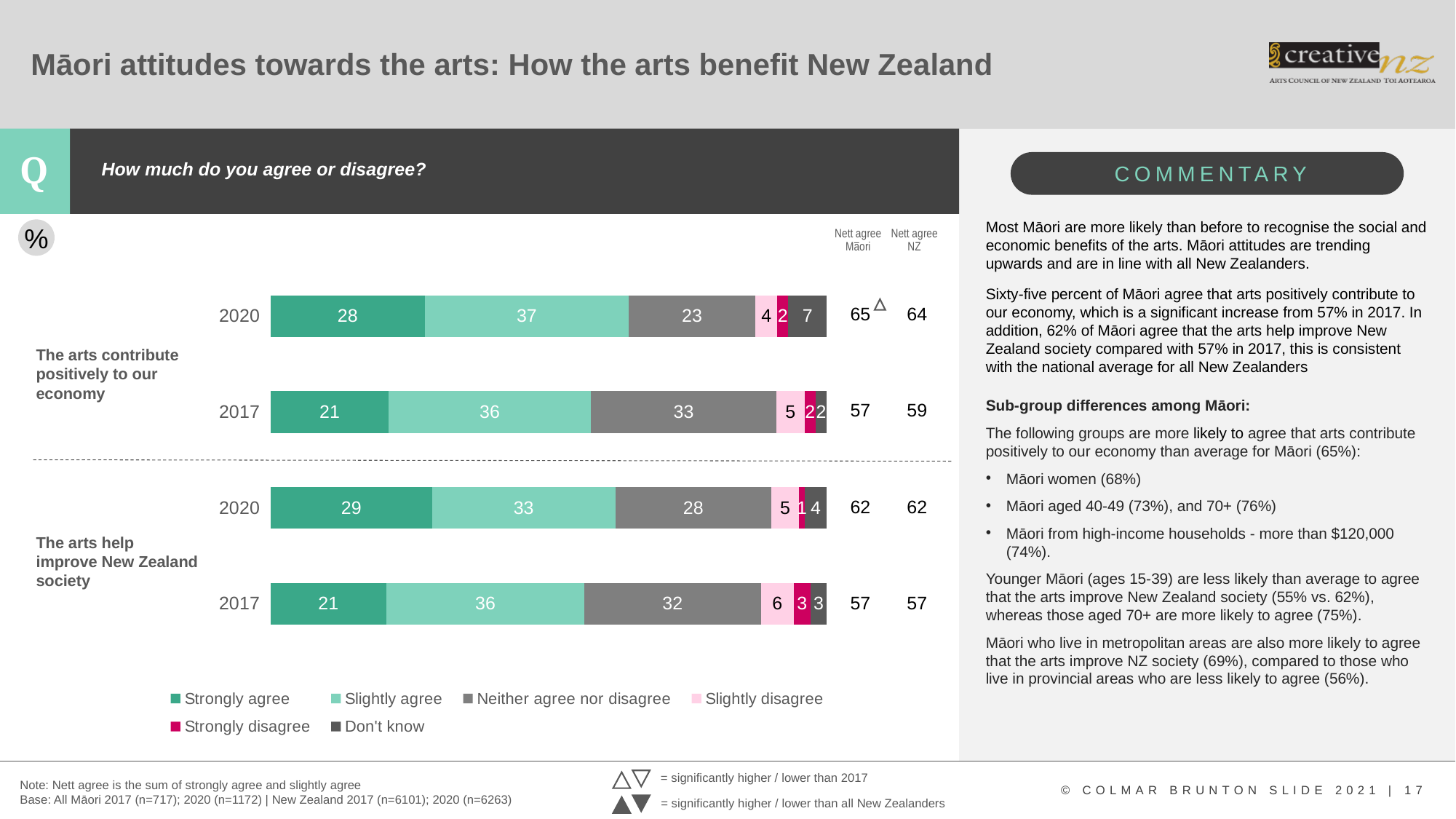
Which bar has the highest 'Strongly agree' value? The arts help improve New Zealand society, 2020 By how many percentage points did 'Strongly agree' for 'The arts contribute positively to our economy' increase from 2017 to 2020? 7 What percentage of Māori strongly agreed in 2020 that the arts contribute positively to our economy? 28 What is the 'Don't know' value for 'The arts contribute positively to our economy' in 2020? 7 How many series does the chart legend list? 6 Which has the larger 'Slightly agree' value in 2020: 'The arts contribute positively to our economy' or 'The arts help improve New Zealand society'? The arts contribute positively to our economy How many bars are plotted in the chart? 4 What is the Nett agree Māori figure for 'The arts help improve New Zealand society' in 2020? 62 What is the Nett agree NZ figure for 'The arts contribute positively to our economy' in 2017? 59 What is the 'Neither agree nor disagree' value for 'The arts contribute positively to our economy' in 2017? 33 What is the sum of 'Strongly agree' and 'Slightly agree' for 'The arts help improve New Zealand society' in 2017? 57 What kind of chart is shown on the slide? Stacked bar chart